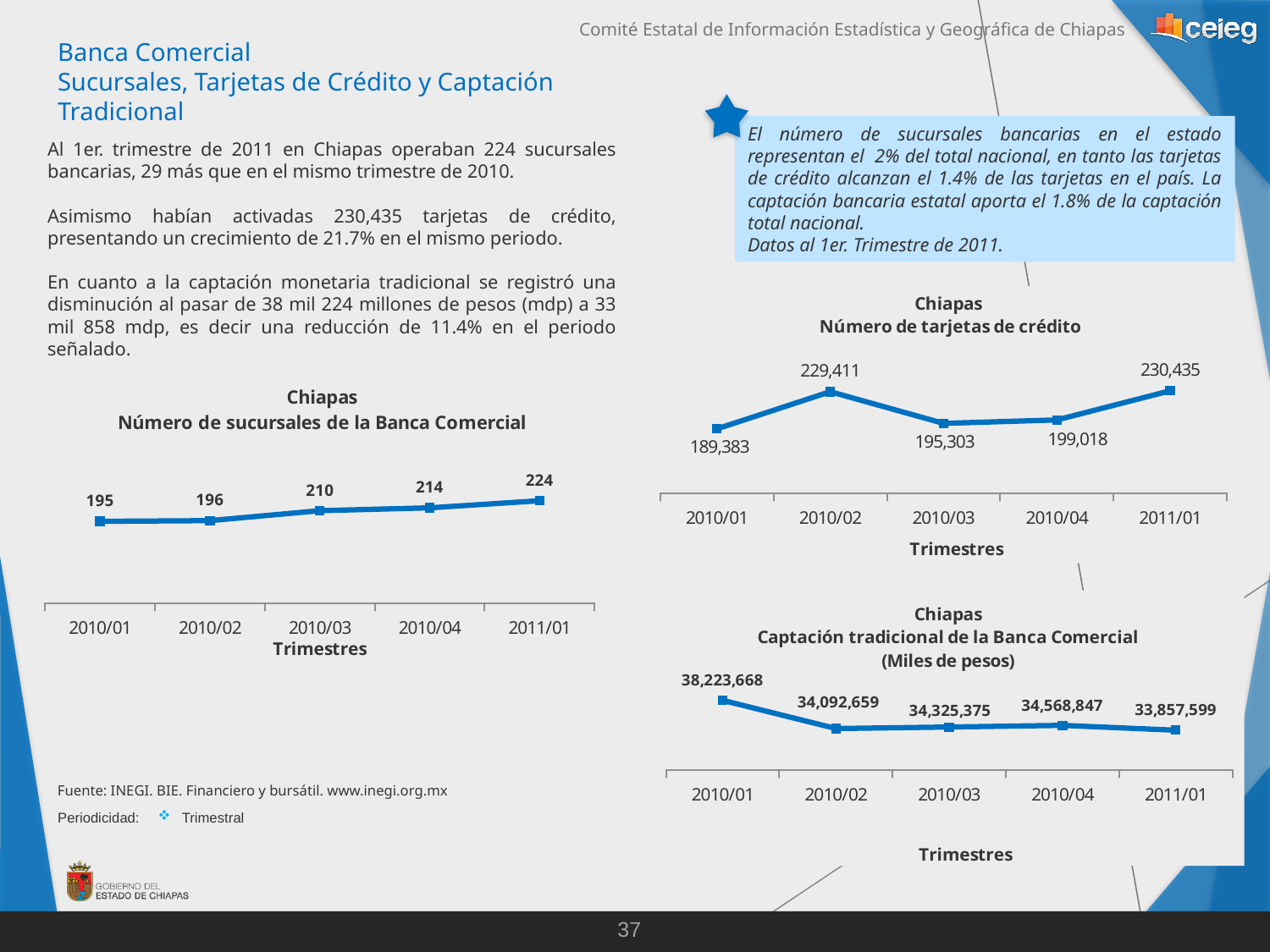
In the chart 'Número de tarjetas de crédito', what is the value for 2010/02? 229,411 In the chart 'Número de sucursales de la Banca Comercial', what is the value for 2011/01? 224 In the chart 'Captación tradicional de la Banca Comercial', what is the value for 2010/01? 38,223,668 In the chart 'Número de tarjetas de crédito', which quarter has the lowest value? 2010/01 In the chart 'Número de tarjetas de crédito', which quarter has the highest value? 2011/01 What type of chart is 'Número de sucursales de la Banca Comercial'? line chart In the chart 'Número de tarjetas de crédito', how many quarters are plotted? 5 In the chart 'Número de sucursales de la Banca Comercial', do the values rise or fall from 2010/01 to 2011/01? rise In the chart 'Captación tradicional de la Banca Comercial', which quarter has the lowest value? 2011/01 In the chart 'Número de sucursales de la Banca Comercial', what is the difference between the values for 2011/01 and 2010/01? 29 In the chart 'Número de sucursales de la Banca Comercial', what is the value for 2010/03? 210 In the chart 'Captación tradicional de la Banca Comercial', which is larger, the value for 2010/03 or 2010/04? 2010/04